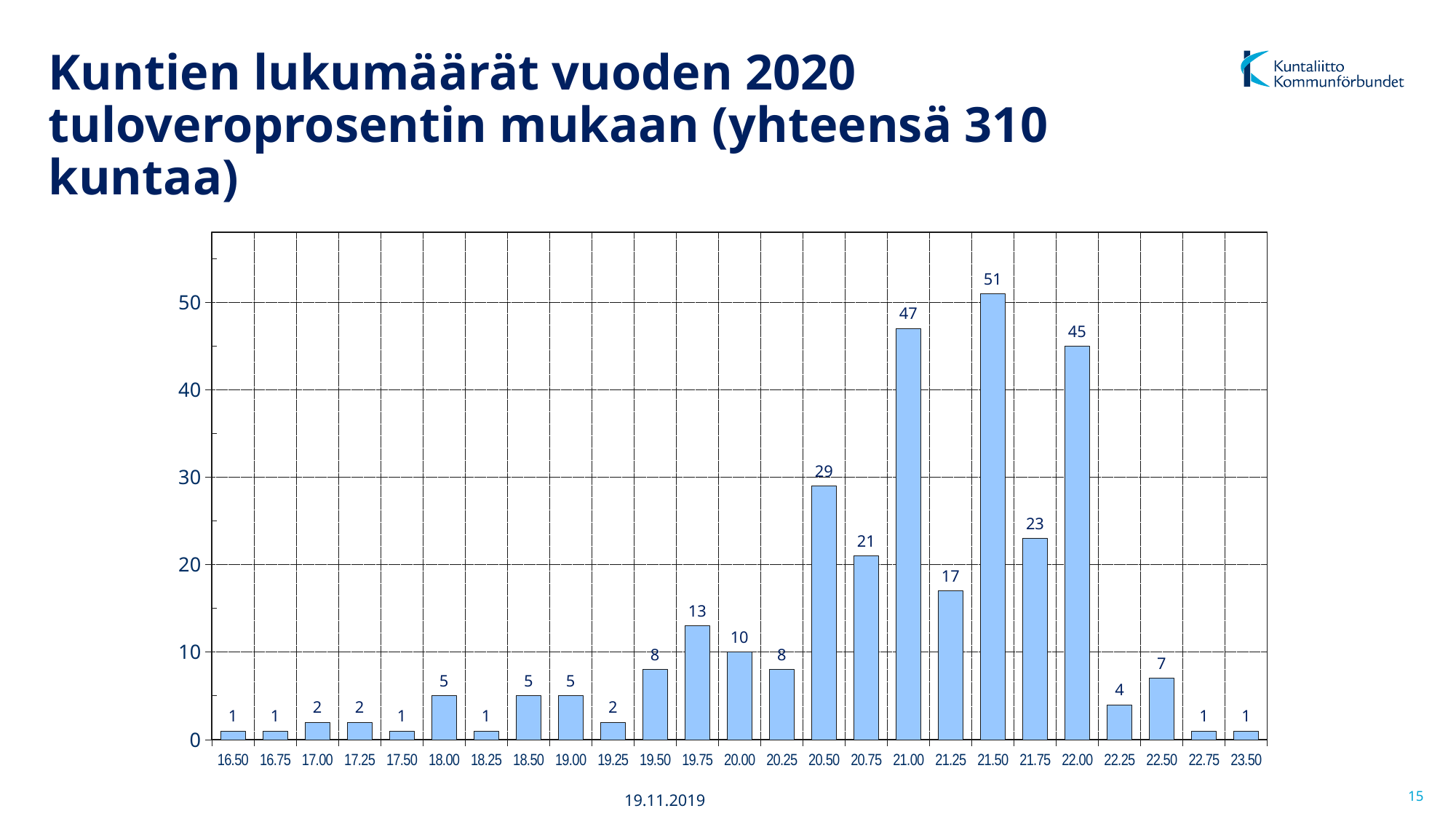
What is the title of the slide? Kuntien lukumäärät vuoden 2020 tuloveroprosentin mukaan (yhteensä 310 kuntaa) How many tax rate categories are shown on the x axis? 25 What is the value shown for the 22.50 category? 7 What is the difference between the values for 20.50 and 20.75? 8 Which has a larger value, 20.50 or 21.75? 20.50 What is the difference between the values for 21.50 and 21.00? 4 What kind of chart is shown on the slide? Bar chart What is the value shown for the 20.50 category? 29 Which tax rate category has the highest number of municipalities? 21.50 What is the value shown for the 19.75 category? 13 Is the value for 21.00 greater or less than 40? greater How many municipalities have a tax rate of 21.50? 51